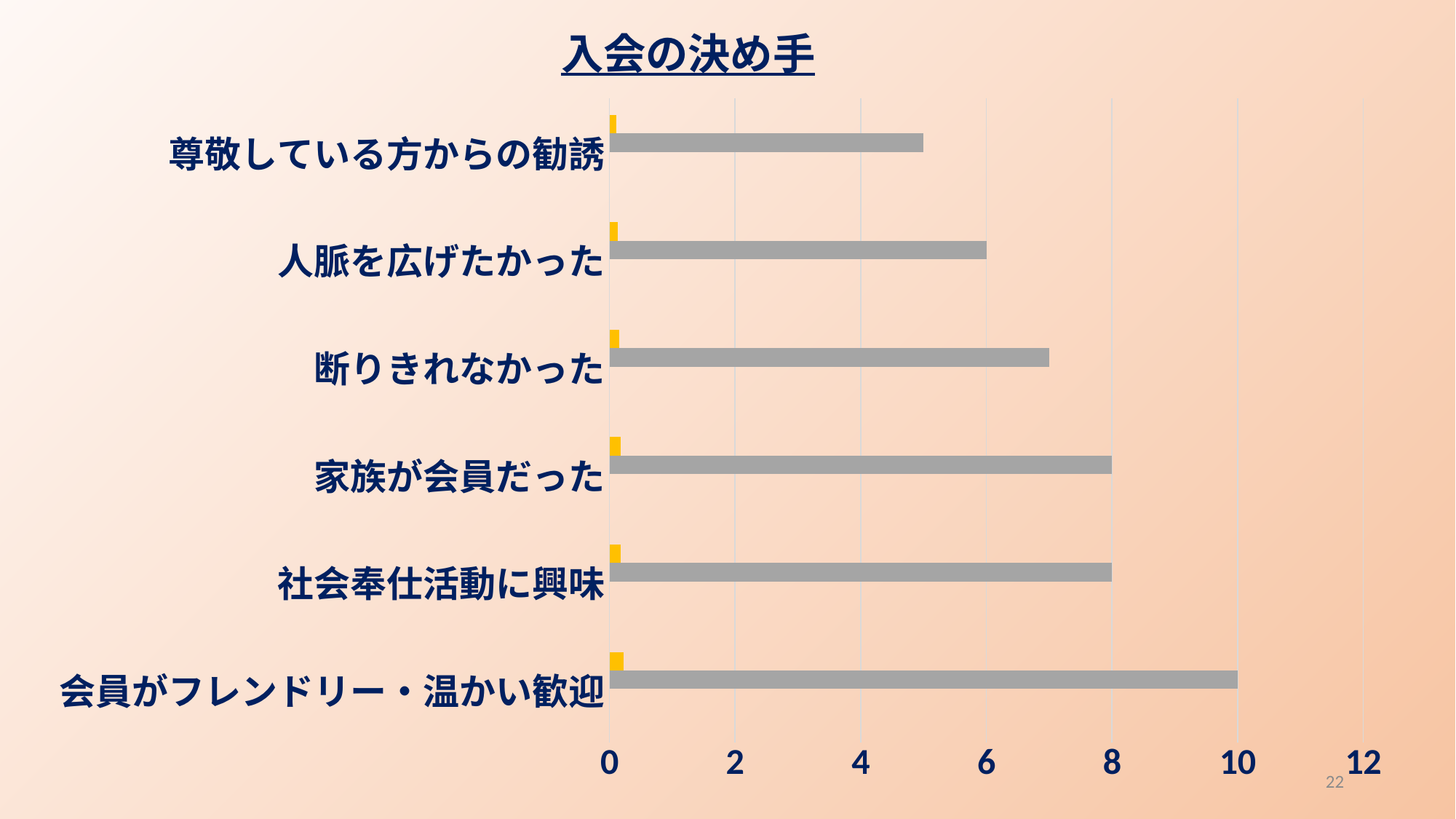
Which category has the highest value? 会員がフレンドリー・温かい歓迎 Is the value for 断りきれなかった greater or less than 6? greater What is the title of the chart? 入会の決め手 What is the difference between the values for 会員がフレンドリー・温かい歓迎 and 社会奉仕活動に興味? 2 How many categories are shown in the chart? 6 Is the value for 尊敬している方からの勧誘 greater or less than 6? less What is the value for 人脈を広げたかった? 6 Which is larger, the value for 断りきれなかった or the value for 人脈を広げたかった? 断りきれなかった What type of chart is shown on the slide? bar chart Which category has the lowest value? 尊敬している方からの勧誘 What is the value for 家族が会員だった? 8 What is the value for 会員がフレンドリー・温かい歓迎? 10